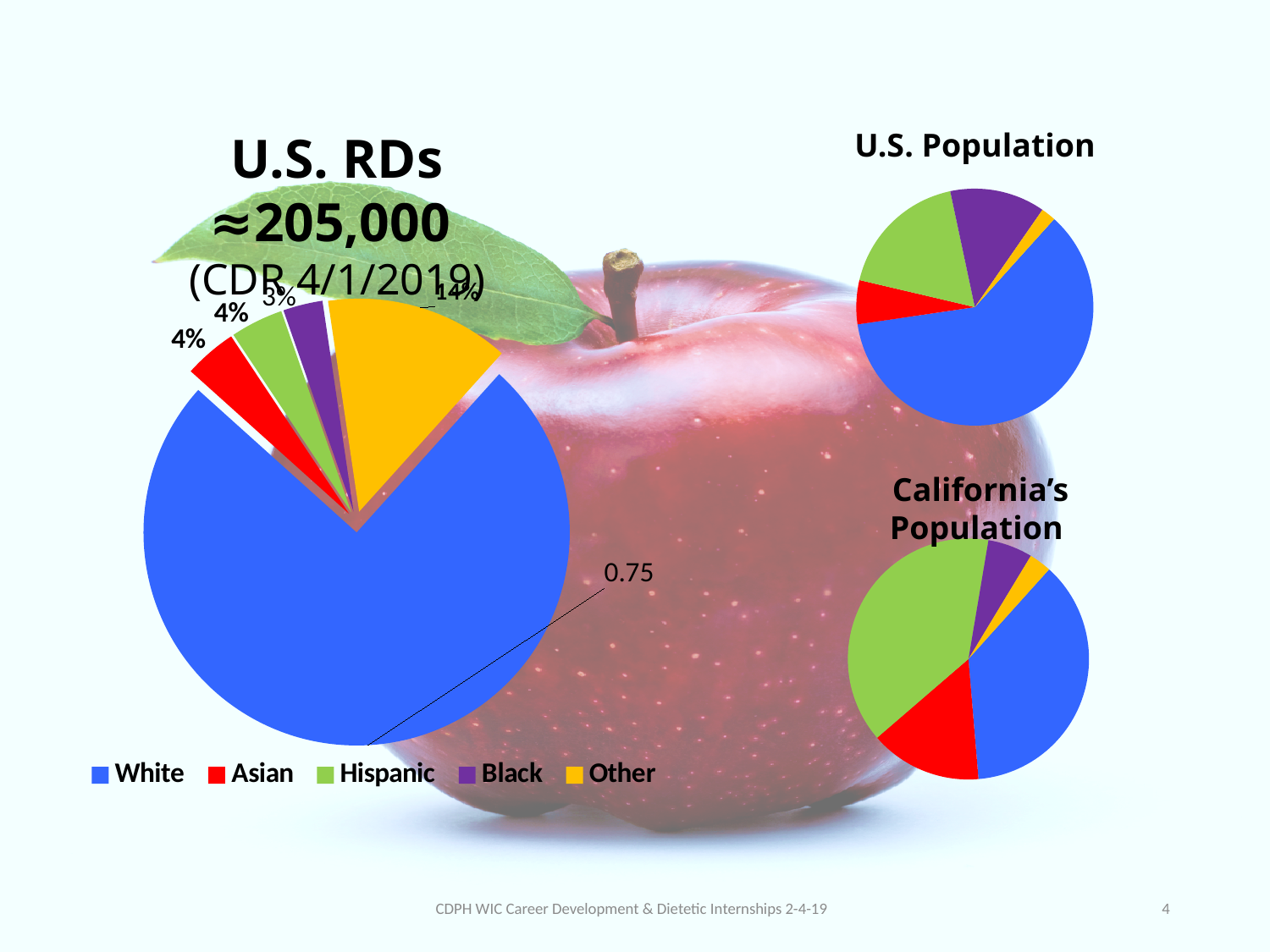
What is the title of the chart in the top right of the slide? U.S. Population In the U.S. RDs chart, what share is labelled for Other? 14% How many entries does the legend of the U.S. RDs chart list? 5 In the U.S. RDs chart, which category has the smallest slice? Black In the U.S. RDs chart, how much larger is the Other share than the Black share? 11% How many slices does the U.S. RDs pie chart have? 5 In the U.S. Population chart, which category has the largest slice? White In the U.S. RDs chart, which category has the largest slice? White In the U.S. RDs chart, what share is labelled for Black? 3% In the U.S. RDs chart, which is larger, the Other slice or the Asian slice? Other In the U.S. RDs chart, what value is labelled for the White slice? 0.75 What kind of chart is the U.S. RDs chart? pie chart